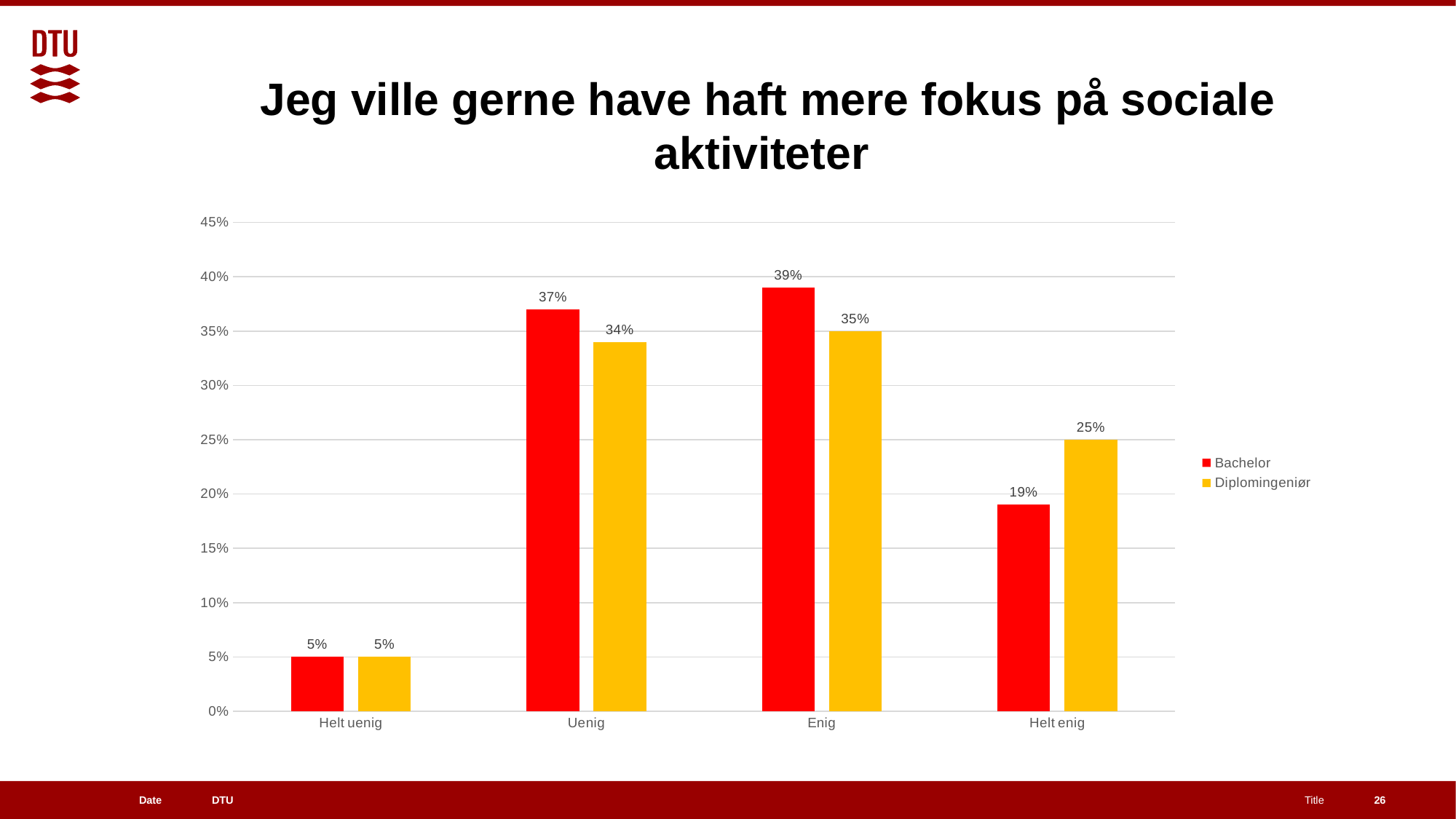
What kind of chart is shown on the slide? Bar chart Which category has the highest Bachelor value? Enig What is the difference between the Bachelor and Diplomingeniør values for Helt enig? 6% What is the difference between the Bachelor values for Enig and Helt uenig? 34% What is the Bachelor value for Uenig? 37% How many series does the legend list? 2 How many categories are shown on the x axis? 4 What is the Diplomingeniør value for Helt enig? 25% Which is larger for Enig: the Bachelor value or the Diplomingeniør value? Bachelor Which category has the lowest Diplomingeniør value? Helt uenig What is the Diplomingeniør value for Enig? 35% Which colour represents the Diplomingeniør series? Yellow